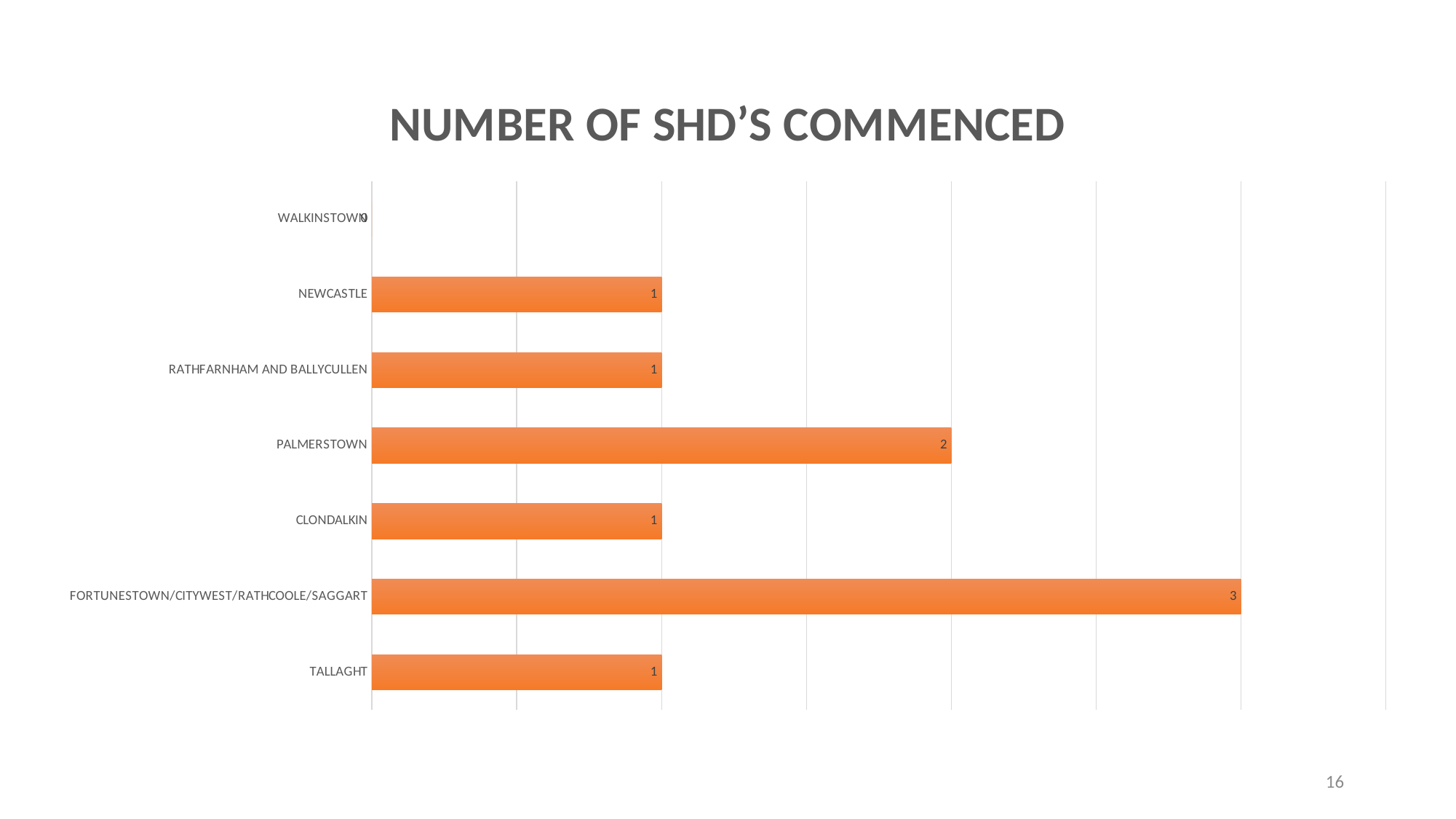
What is the title of the chart? NUMBER OF SHD'S COMMENCED Which area has the highest number of SHD's commenced? Fortunestown/Citywest/Rathcoole/Saggart What is the number of SHD's commenced for Walkinstown? 0 What is the difference between the number of SHD's commenced in Fortunestown/Citywest/Rathcoole/Saggart and in Palmerstown? 1 What colour are the bars in the chart? Orange What kind of chart is shown on the slide? Bar chart What is the number of SHD's commenced for Fortunestown/Citywest/Rathcoole/Saggart? 3 Which area has the lowest number of SHD's commenced? Walkinstown How many areas are shown on the chart? 7 Which has more SHD's commenced, Palmerstown or Clondalkin? Palmerstown What is the number of SHD's commenced for Tallaght? 1 What is the number of SHD's commenced for Palmerstown? 2